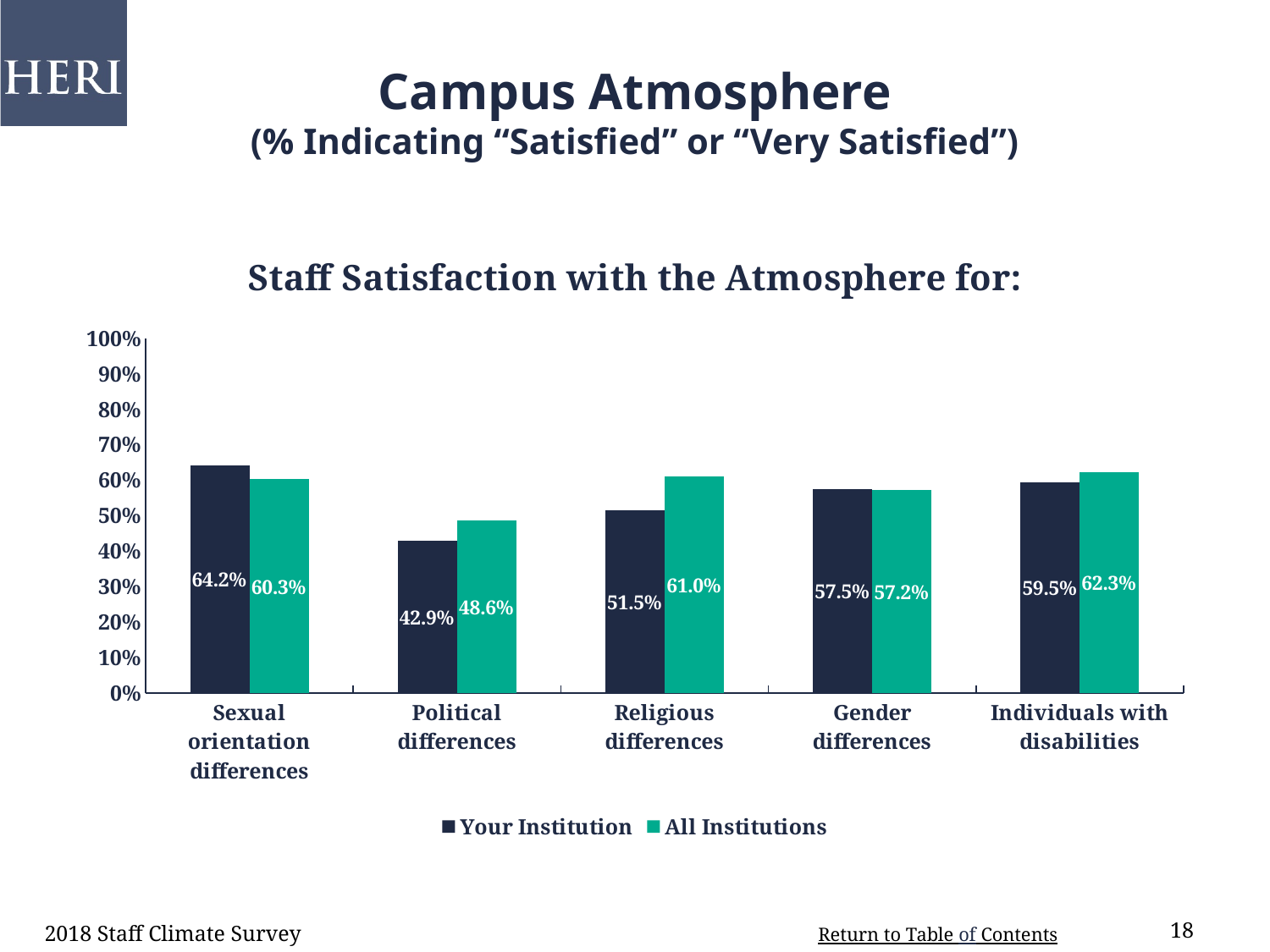
What is the value for All Institutions for Political differences? 48.6% Which category has the highest value for All Institutions? Individuals with disabilities What is the difference between All Institutions and Your Institution for Religious differences? 9.5% Which category has the lowest value for Your Institution? Political differences What is the value for Your Institution for Religious differences? 51.5% What kind of chart is shown on the slide? Bar chart What is the value for All Institutions for Individuals with disabilities? 62.3% How many series does the legend list? 2 How many categories are shown on the x axis? 5 What is the value for Your Institution for Sexual orientation differences? 64.2% Which is larger for Political differences: Your Institution or All Institutions? All Institutions What is the title of the chart? Staff Satisfaction with the Atmosphere for: